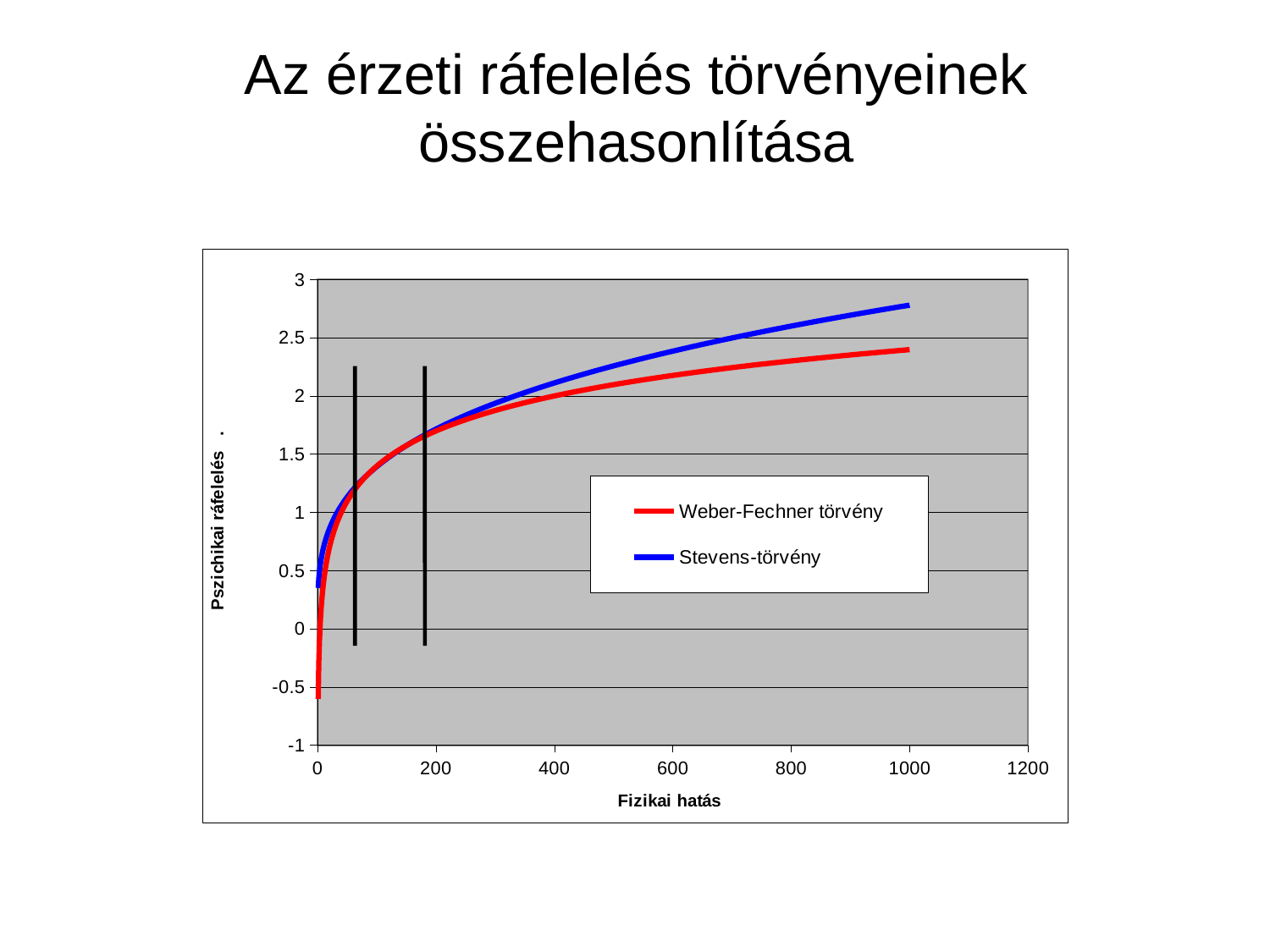
Is the value of the Stevens-törvény series at Fizikai hatás 1000 greater or less than 2.5? greater What is the highest value shown on the y axis? 3 How many series does the legend list? 2 What is the title of the x axis? Fizikai hatás Do the values of the Stevens-törvény series rise or fall as Fizikai hatás increases? rise Is the value of the Weber-Fechner törvény series at Fizikai hatás 600 greater or less than 2? greater Which series is drawn in red? Weber-Fechner törvény Is the value of the Stevens-törvény series at Fizikai hatás 200 greater or less than 2? less What kind of chart is shown on the slide? line chart At Fizikai hatás 1000, which series has the higher value, Weber-Fechner törvény or Stevens-törvény? Stevens-törvény Do the values of the Weber-Fechner törvény series rise or fall as Fizikai hatás increases from 200 to 1000? rise